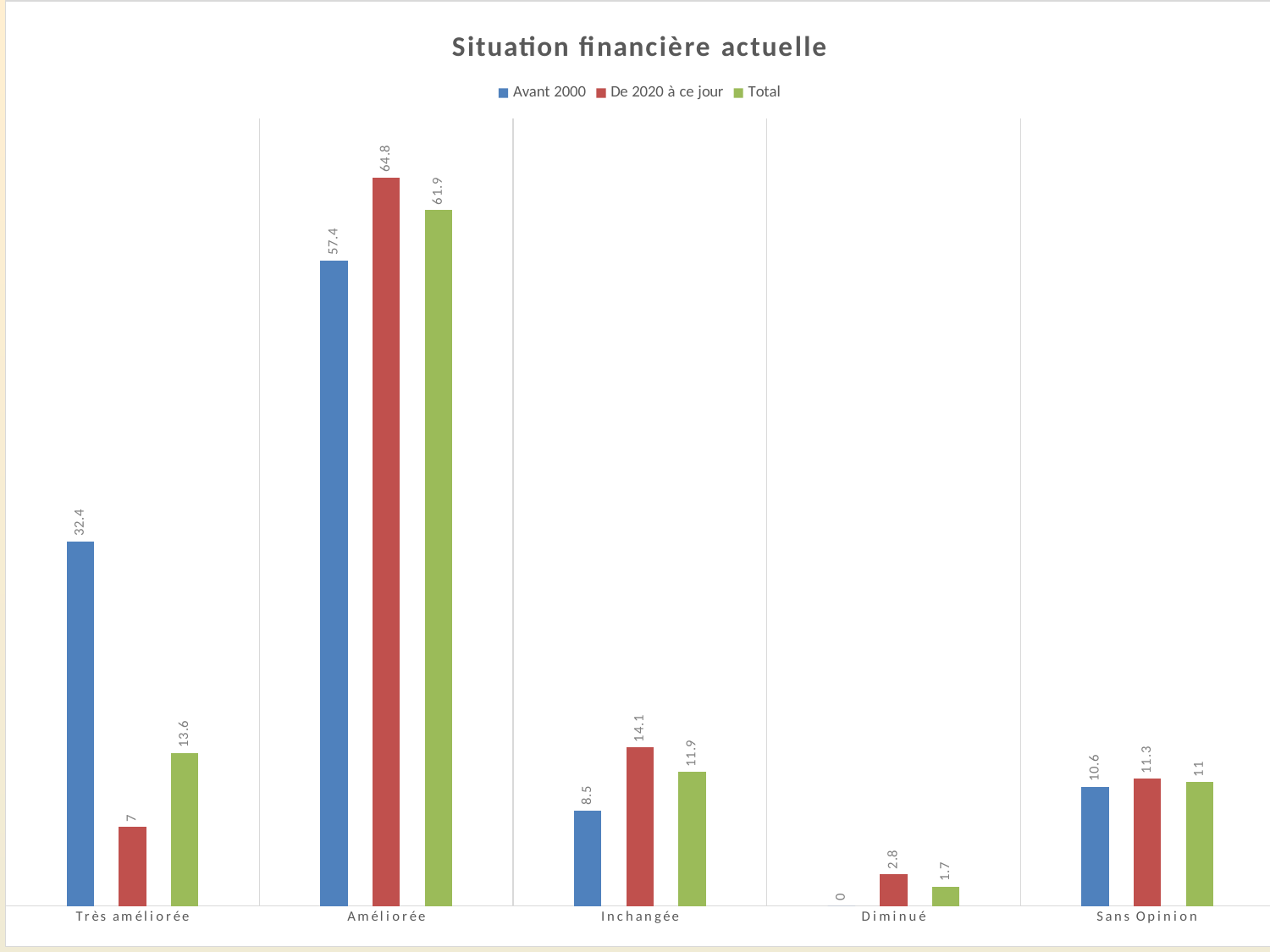
How many categories are shown on the x axis? 5 What is the difference between the 'De 2020 à ce jour' and 'Avant 2000' values for 'Améliorée'? 7.4 Which category has the lowest 'De 2020 à ce jour' value? Diminué What kind of chart is shown on the slide? Bar chart What is the title of the chart? Situation financière actuelle How many series does the legend list? 3 What is the value for 'Avant 2000' in the 'Diminué' category? 0 Which is larger for 'Très améliorée': the 'Avant 2000' value or the 'Total' value? Avant 2000 What is the value for 'De 2020 à ce jour' in the 'Améliorée' category? 64.8 Which category has the highest 'Total' value? Améliorée What is the value for 'Avant 2000' in the 'Très améliorée' category? 32.4 What is the 'Total' value for 'Inchangée'? 11.9